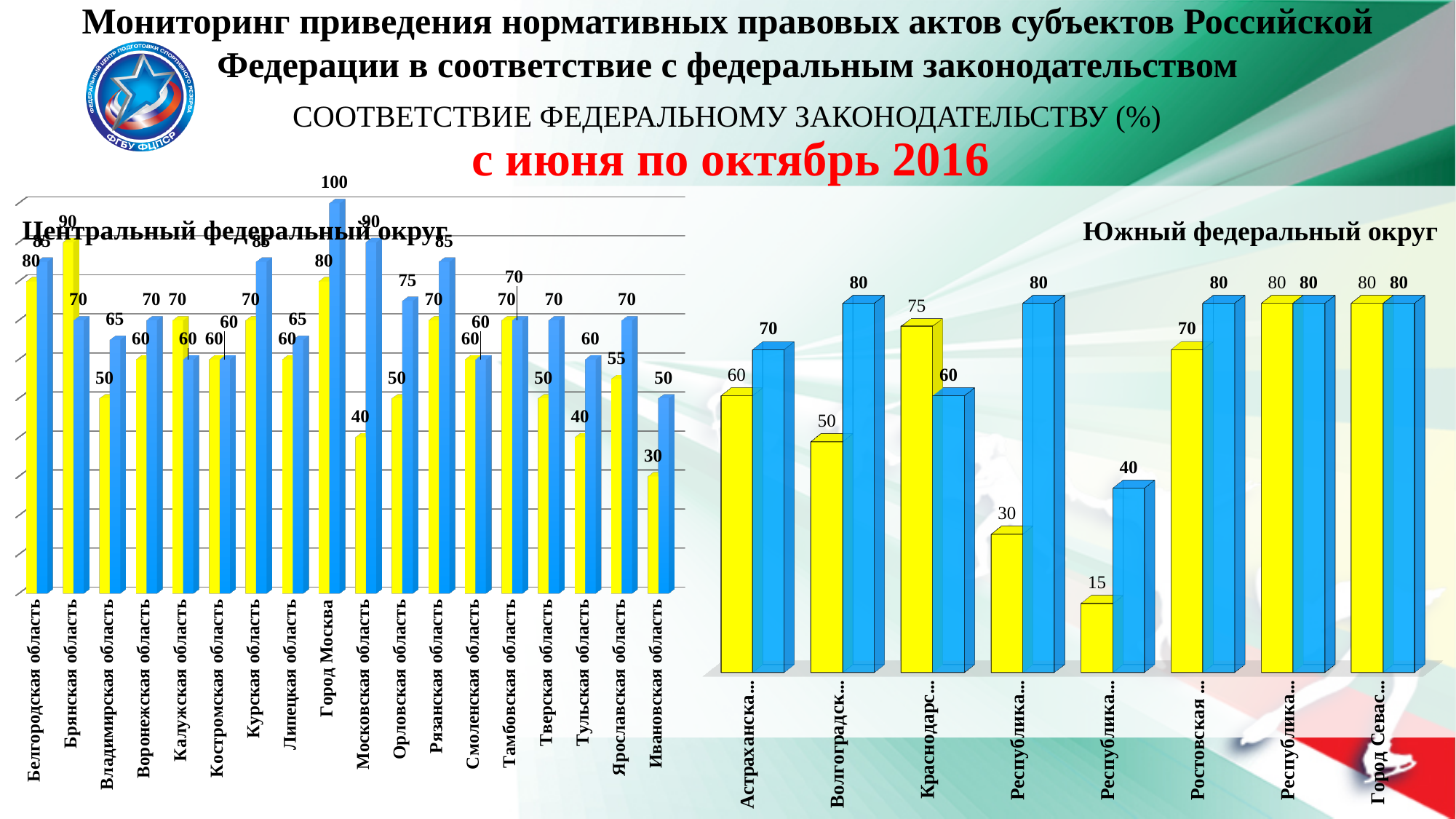
On the Южный федеральный округ chart, what is the difference between the blue and yellow bars for Астраханска...? 10 On the Центральный федеральный округ chart, what is the difference between the blue and yellow bars for Московская область? 50 On the Южный федеральный округ chart, what is the value of the blue bar for Волгоградск...? 80 On the Центральный федеральный округ chart, how many categories are shown on the x axis? 18 What type of chart is the Южный федеральный округ chart? bar chart On the Центральный федеральный округ chart, which is larger for Брянская область: the yellow bar or the blue bar? the yellow bar On the Центральный федеральный округ chart, which category has the lowest yellow bar? Ивановская область On the Южный федеральный округ chart, how many categories are shown on the x axis? 8 On the Центральный федеральный округ chart, what is the value of the yellow bar for Ивановская область? 30 On the Центральный федеральный округ chart, which category has the highest blue bar? Город Москва On the Центральный федеральный округ chart, what is the value of the blue bar for Город Москва? 100 On the Южный федеральный округ chart, what is the value of the yellow bar for Краснодарс...? 75